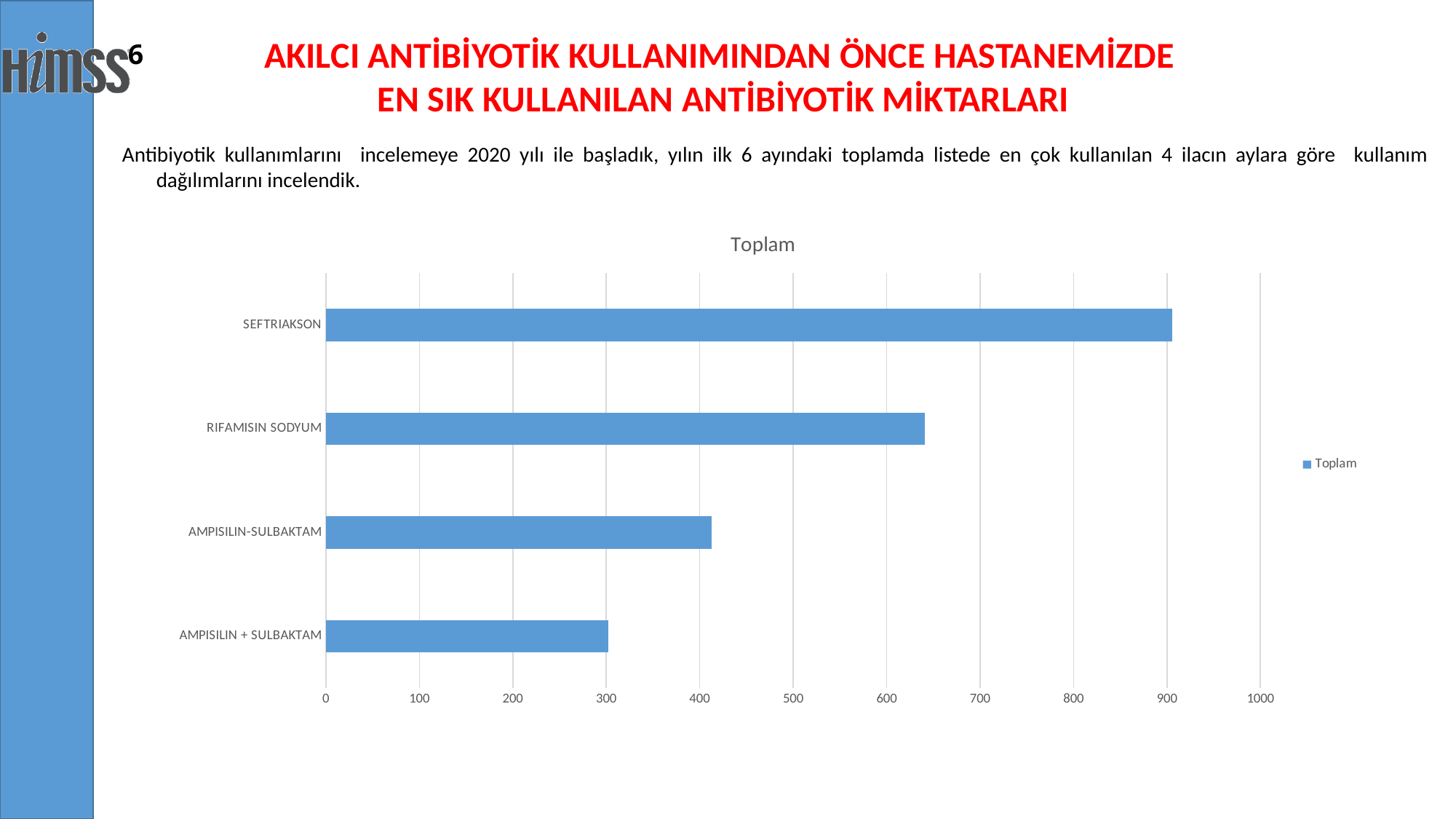
Which category has the lowest value? AMPISILIN + SULBAKTAM How many series does the legend list? 1 Which is larger, the value for RIFAMISIN SODYUM or the value for AMPISILIN-SULBAKTAM? RIFAMISIN SODYUM What is the title of the chart? Toplam How many categories are plotted in the chart? 4 Which category has the highest value? SEFTRIAKSON Is the value for AMPISILIN + SULBAKTAM greater or less than 400? less Is the value for RIFAMISIN SODYUM greater or less than 700? less What is the name of the series shown in the legend? Toplam Is the value for SEFTRIAKSON greater or less than 800? greater What kind of chart is shown on the slide? bar chart